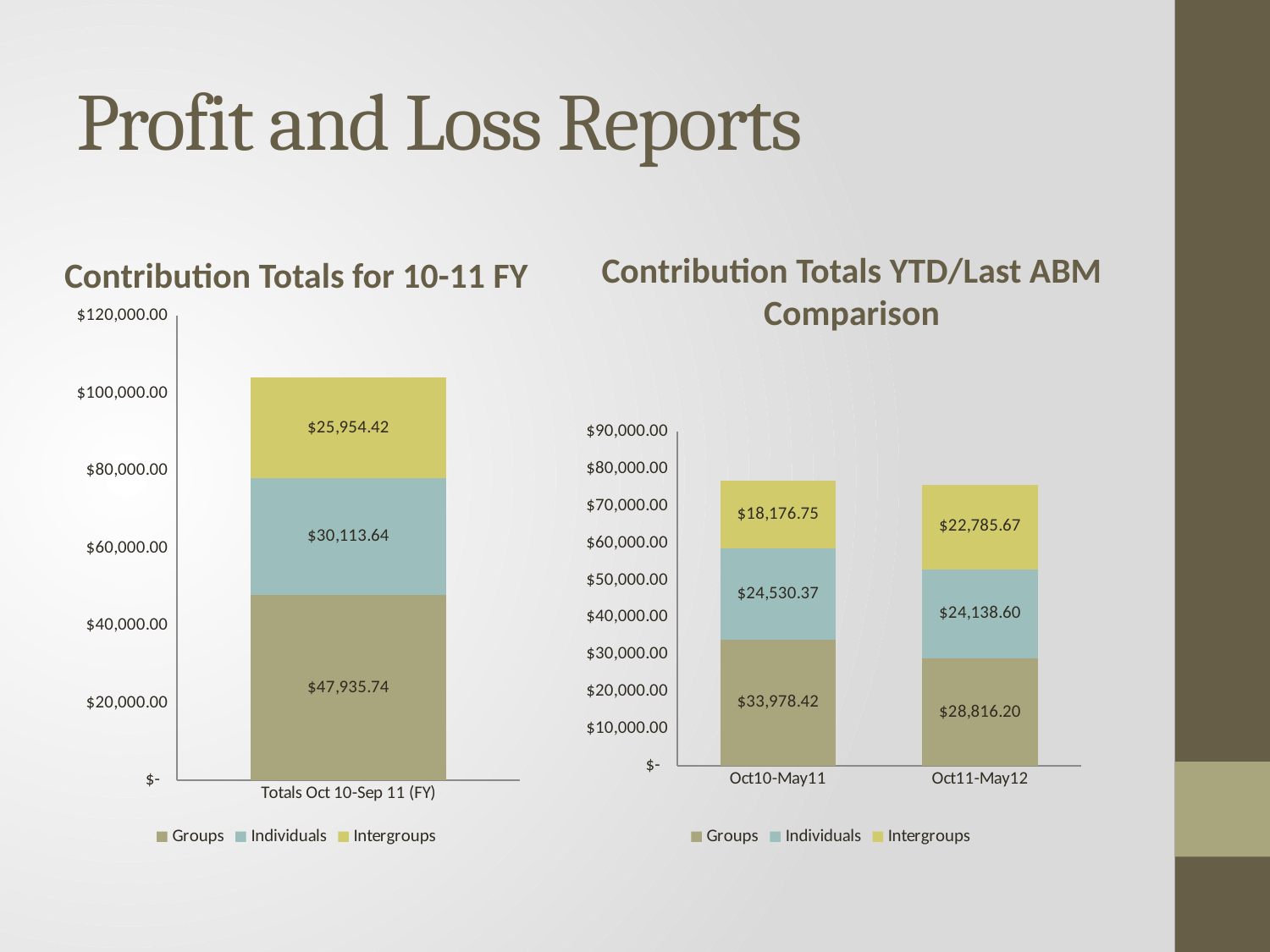
In the 'Contribution Totals for 10-11 FY' chart, which series has the largest value? Groups In the 'Contribution Totals YTD/Last ABM Comparison' chart, what is the value for Individuals in Oct11-May12? $24,138.60 How many series does the legend of the 'Contribution Totals for 10-11 FY' chart list? 3 What kind of chart is the 'Contribution Totals YTD/Last ABM Comparison' chart? Stacked bar chart In the 'Contribution Totals YTD/Last ABM Comparison' chart, what is the difference between the Groups values for Oct10-May11 and Oct11-May12? $5,162.22 In the 'Contribution Totals for 10-11 FY' chart, what is the value for Groups? $47,935.74 In the 'Contribution Totals YTD/Last ABM Comparison' chart, what is the value for Intergroups in Oct10-May11? $18,176.75 In the 'Contribution Totals YTD/Last ABM Comparison' chart, which period has the larger Intergroups value? Oct11-May12 In the 'Contribution Totals YTD/Last ABM Comparison' chart, what is the total of the Oct10-May11 stacked bar? $76,685.54 In the 'Contribution Totals for 10-11 FY' chart, what is the value for Intergroups? $25,954.42 In the 'Contribution Totals for 10-11 FY' chart, what is the total of the stacked bar? $104,003.80 In the 'Contribution Totals YTD/Last ABM Comparison' chart, how many categories are shown on the x axis? 2